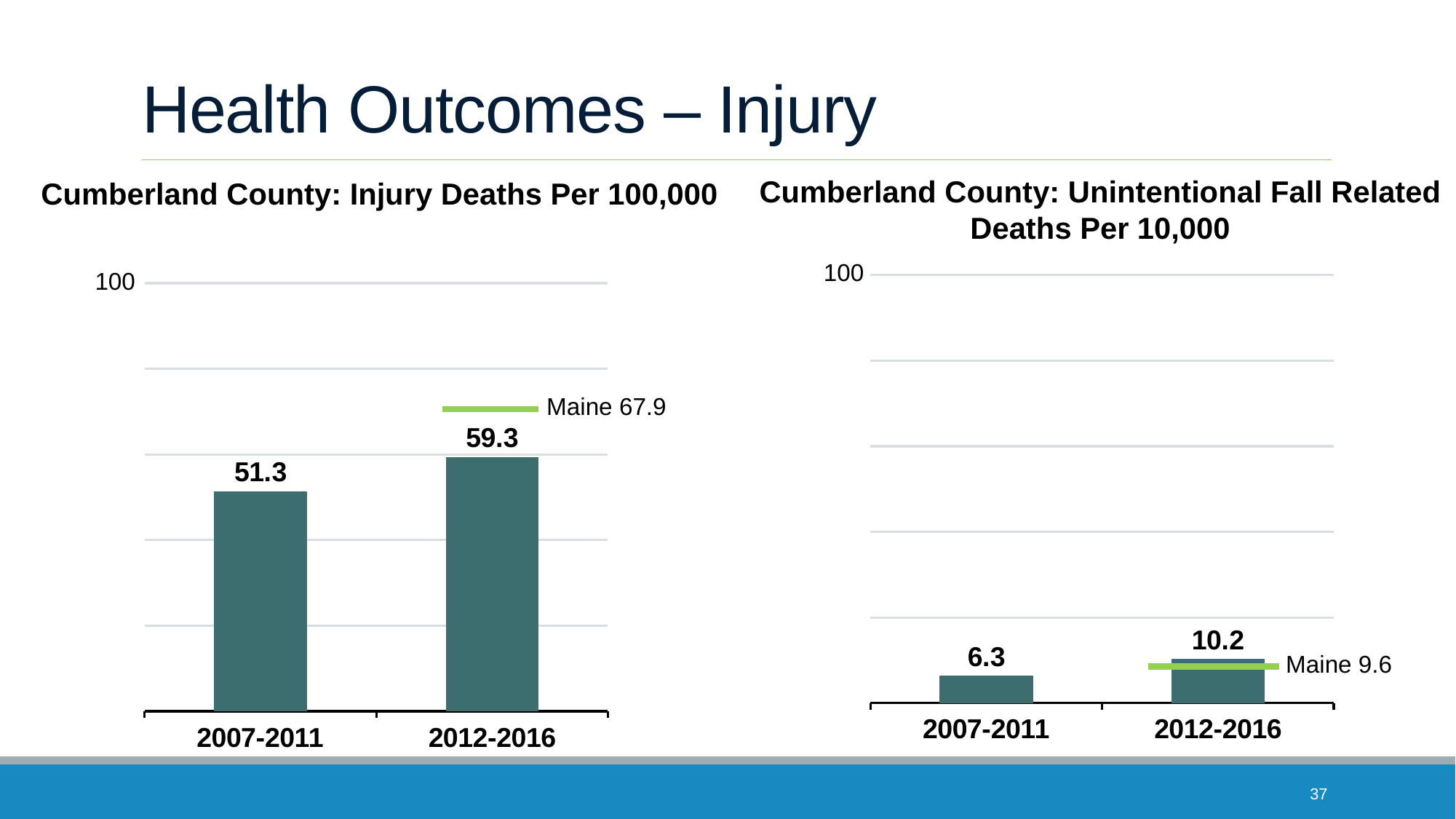
In the 'Cumberland County: Injury Deaths Per 100,000' chart, do the values rise or fall from 2007-2011 to 2012-2016? rise In the 'Cumberland County: Unintentional Fall Related Deaths Per 10,000' chart, which period has the higher value? 2012-2016 What kind of chart is the 'Cumberland County: Injury Deaths Per 100,000' chart? bar chart In the 'Cumberland County: Unintentional Fall Related Deaths Per 10,000' chart, what is the value for 2007-2011? 6.3 In the 'Cumberland County: Unintentional Fall Related Deaths Per 10,000' chart, what is the difference between the 2012-2016 and 2007-2011 values? 3.9 In the 'Cumberland County: Injury Deaths Per 100,000' chart, what is the difference between the 2012-2016 and 2007-2011 values? 8.0 In the 'Cumberland County: Unintentional Fall Related Deaths Per 10,000' chart, what is the value for 2012-2016? 10.2 In the 'Cumberland County: Injury Deaths Per 100,000' chart, what is the Maine value shown by the green line? 67.9 How many time periods are shown in the 'Cumberland County: Unintentional Fall Related Deaths Per 10,000' chart? 2 In the 'Cumberland County: Unintentional Fall Related Deaths Per 10,000' chart, what is the Maine value shown by the green line? 9.6 In the 'Cumberland County: Injury Deaths Per 100,000' chart, what is the value for 2007-2011? 51.3 In the 'Cumberland County: Injury Deaths Per 100,000' chart, what is the value for 2012-2016? 59.3